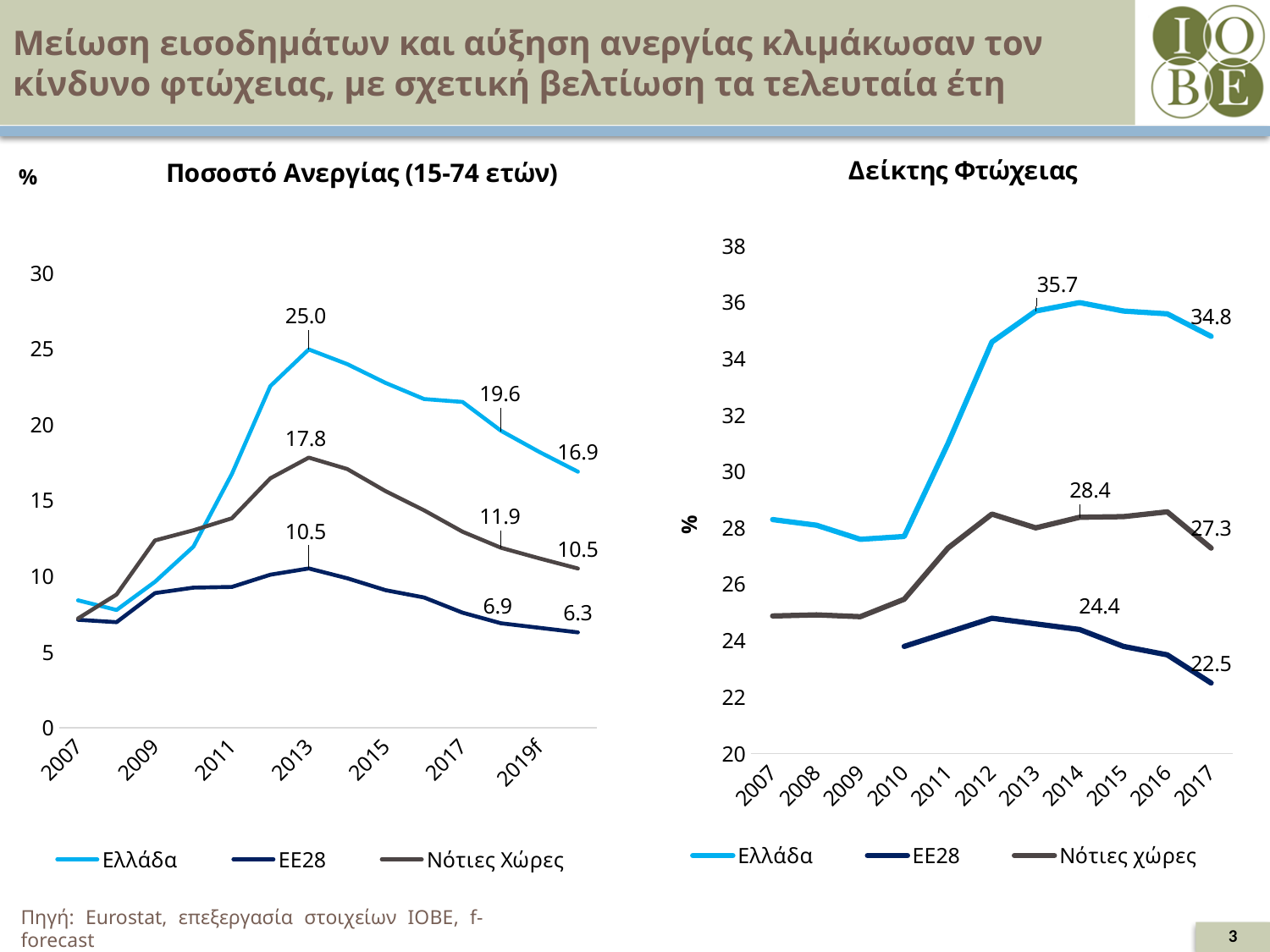
In the 'Ποσοστό Ανεργίας (15-74 ετών)' chart, what is the value for Ελλάδα in 2013? 25.0 In the 'Δείκτης Φτώχειας' chart, which series has the highest value in 2017? Ελλάδα In the 'Δείκτης Φτώχειας' chart, what is the value for ΕΕ28 in 2014? 24.4 In the 'Δείκτης Φτώχειας' chart, what is the difference between the Νότιες χώρες and ΕΕ28 values in 2017? 4.8 In the 'Δείκτης Φτώχειας' chart, what is the value for Ελλάδα in 2017? 34.8 What type of chart is the 'Ποσοστό Ανεργίας (15-74 ετών)' chart? line chart In the 'Δείκτης Φτώχειας' chart, how many years are shown on the x axis? 11 In the 'Ποσοστό Ανεργίας (15-74 ετών)' chart, is the value for Ελλάδα in 2007 greater or less than 10? less In the 'Ποσοστό Ανεργίας (15-74 ετών)' chart, how many series does the legend list? 3 In the 'Ποσοστό Ανεργίας (15-74 ετών)' chart, does the Ελλάδα line rise or fall from 2013 to 2019f? fall